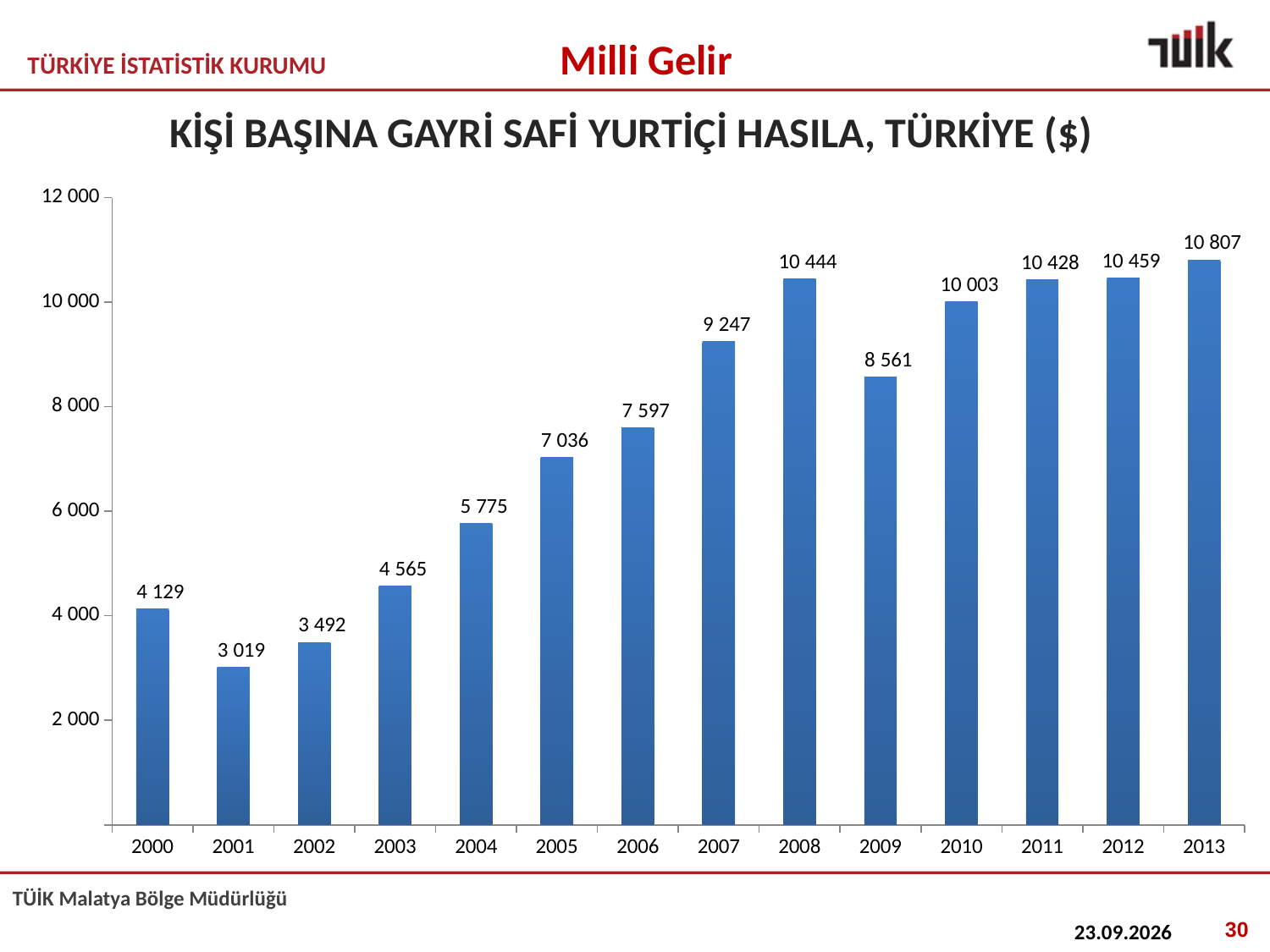
What is the difference between the values for 2008 and 2009? 1 883 Which is larger, the value for 2007 or the value for 2009? 2007 Do the values rise or fall from 2000 to 2001? fall What is the title of the chart? KİŞİ BAŞINA GAYRİ SAFİ YURTİÇİ HASILA, TÜRKİYE ($) Is the value for 2006 greater or less than 8 000? less What kind of chart is shown on the slide? bar chart Which year has the highest value in the chart? 2013 Which year has the lowest value in the chart? 2001 What is the value shown for 2001? 3 019 How many years are shown on the x axis of the chart? 14 What is the value shown for 2013? 10 807 What is the GDP per capita value shown for 2008? 10 444